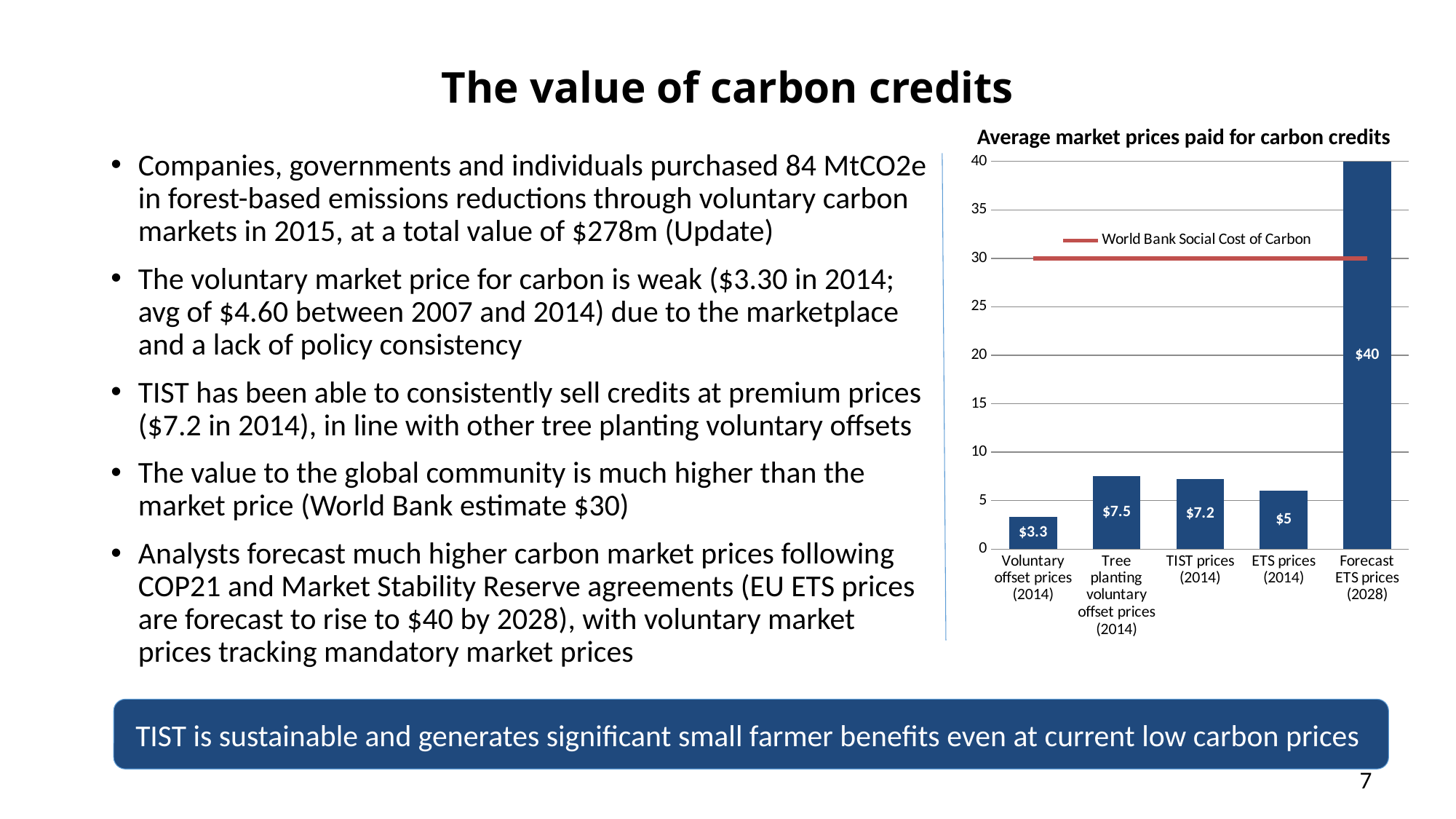
How many bars are shown in the chart? 5 What does the red horizontal line in the chart represent? World Bank Social Cost of Carbon What kind of chart is shown on the slide? Combination bar and line chart Is the value for Forecast ETS prices (2028) greater or less than 30? greater Which category has the lowest value? Voluntary offset prices (2014) What is the difference between Tree planting voluntary offset prices (2014) and Voluntary offset prices (2014)? $4.2 What is the value for TIST prices (2014)? $7.2 Which is larger, TIST prices (2014) or ETS prices (2014)? TIST prices (2014) Which category has the highest value? Forecast ETS prices (2028) What is the value for Forecast ETS prices (2028)? $40 What is the value for Voluntary offset prices (2014)? $3.3 What is the value for ETS prices (2014)? $5